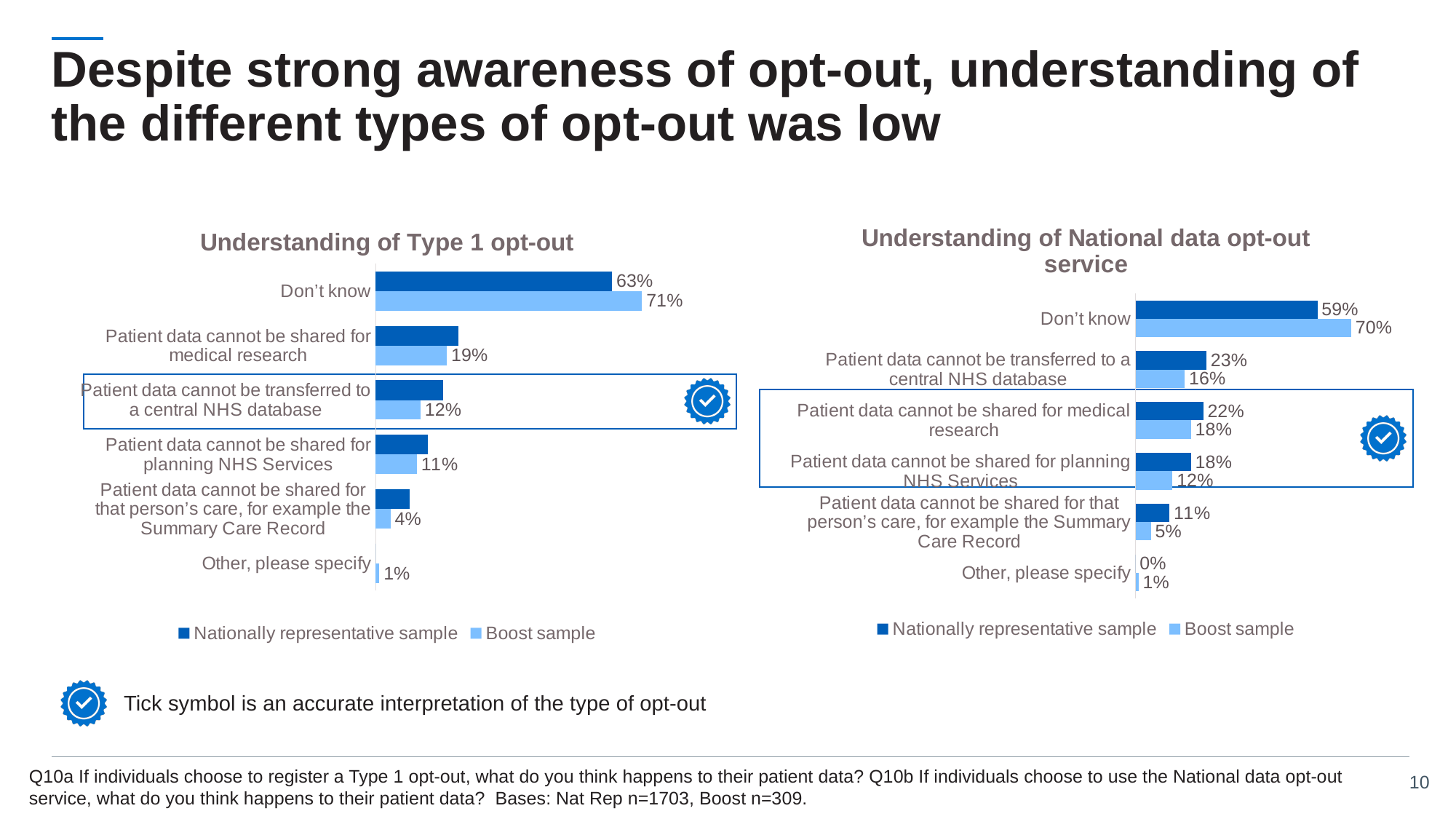
In the 'Understanding of National data opt-out service' chart, what is the Nationally representative sample value for 'Patient data cannot be transferred to a central NHS database'? 23% In the 'Understanding of National data opt-out service' chart, what is the difference between the Boost sample and the Nationally representative sample for 'Don't know'? 11 percentage points In the 'Understanding of National data opt-out service' chart, what is the Nationally representative sample value for 'Other, please specify'? 0% In the 'Understanding of Type 1 opt-out' chart, what is the value for the Nationally representative sample for 'Don't know'? 63% In the 'Understanding of National data opt-out service' chart, what is the Nationally representative sample value for 'Don't know'? 59% How many categories are shown in the 'Understanding of Type 1 opt-out' chart? 6 In the 'Understanding of Type 1 opt-out' chart, what is the difference between the Boost sample and the Nationally representative sample for 'Don't know'? 8 percentage points In the 'Understanding of Type 1 opt-out' chart, which category has the lowest Boost sample value? Other, please specify In the 'Understanding of Type 1 opt-out' chart, what is the value for the Boost sample for 'Don't know'? 71% How many series does the legend of the 'Understanding of National data opt-out service' chart list? 2 In the 'Understanding of Type 1 opt-out' chart, what is the Boost sample value for 'Patient data cannot be shared for medical research'? 19% In the 'Understanding of National data opt-out service' chart, which sample has the larger value for 'Patient data cannot be shared for planning NHS Services'? Nationally representative sample